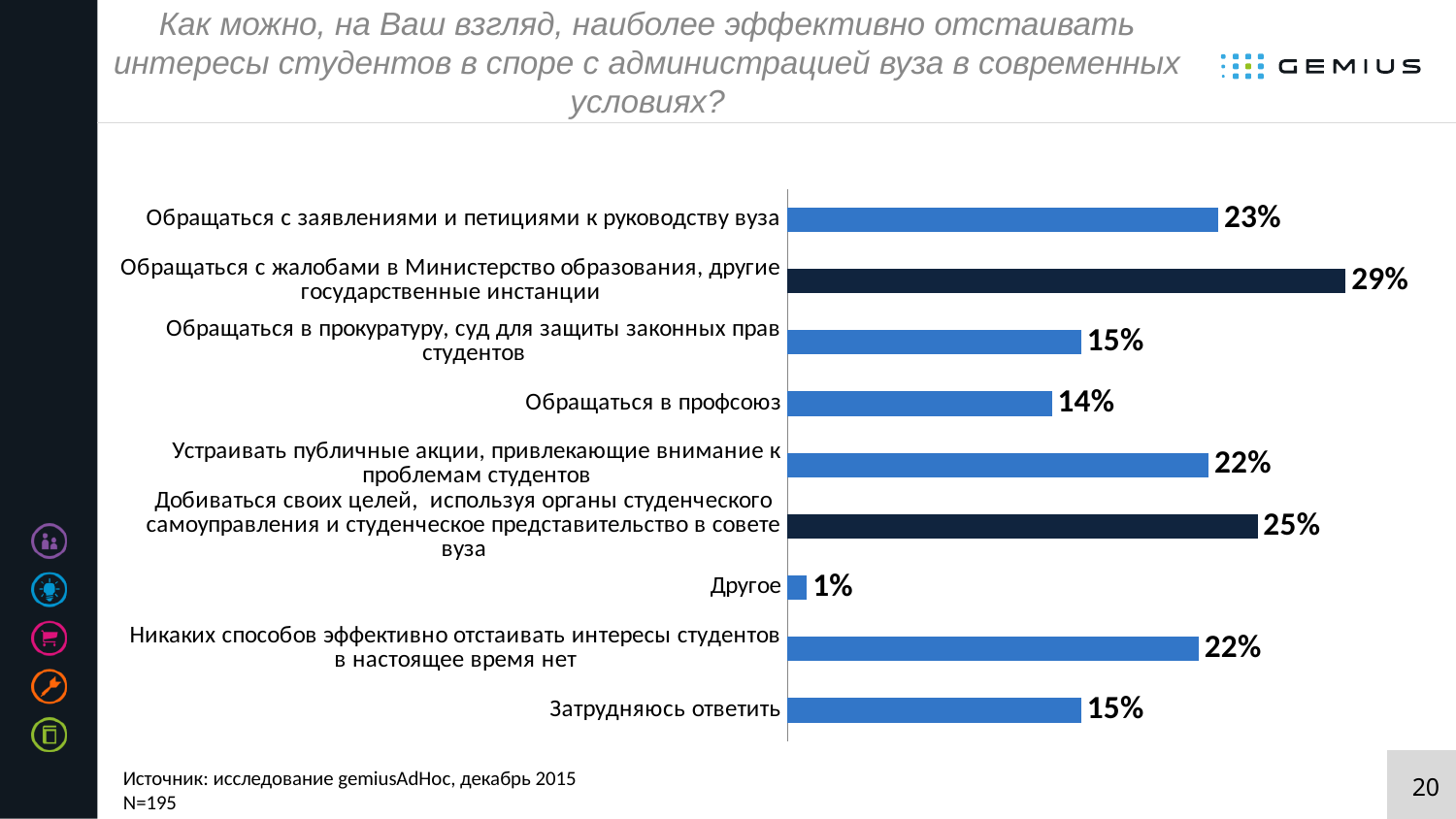
Which category has the highest value on the chart? Обращаться с жалобами в Министерство образования, другие государственные инстанции Which is larger: the value for "Добиваться своих целей, используя органы студенческого самоуправления и студенческое представительство в совете вуза" or the value for "Устраивать публичные акции, привлекающие внимание к проблемам студентов"? Добиваться своих целей, используя органы студенческого самоуправления и студенческое представительство в совете вуза What is the difference between the values for "Обращаться с жалобами в Министерство образования, другие государственные инстанции" and "Обращаться с заявлениями и петициями к руководству вуза"? 6% How many categories are shown on the chart? 9 What percentage is shown for "Другое"? 1% What is the value for "Затрудняюсь ответить"? 15% Which category has the lowest value on the chart? Другое What is the value shown for "Обращаться в профсоюз"? 14% What is the difference between the values for "Обращаться в прокуратуру, суд для защиты законных прав студентов" and "Обращаться в профсоюз"? 1% What type of chart is shown on the slide? Bar chart What is the sample size (N) stated at the bottom of the slide? N=195 What percentage of respondents chose "Обращаться с жалобами в Министерство образования, другие государственные инстанции"? 29%